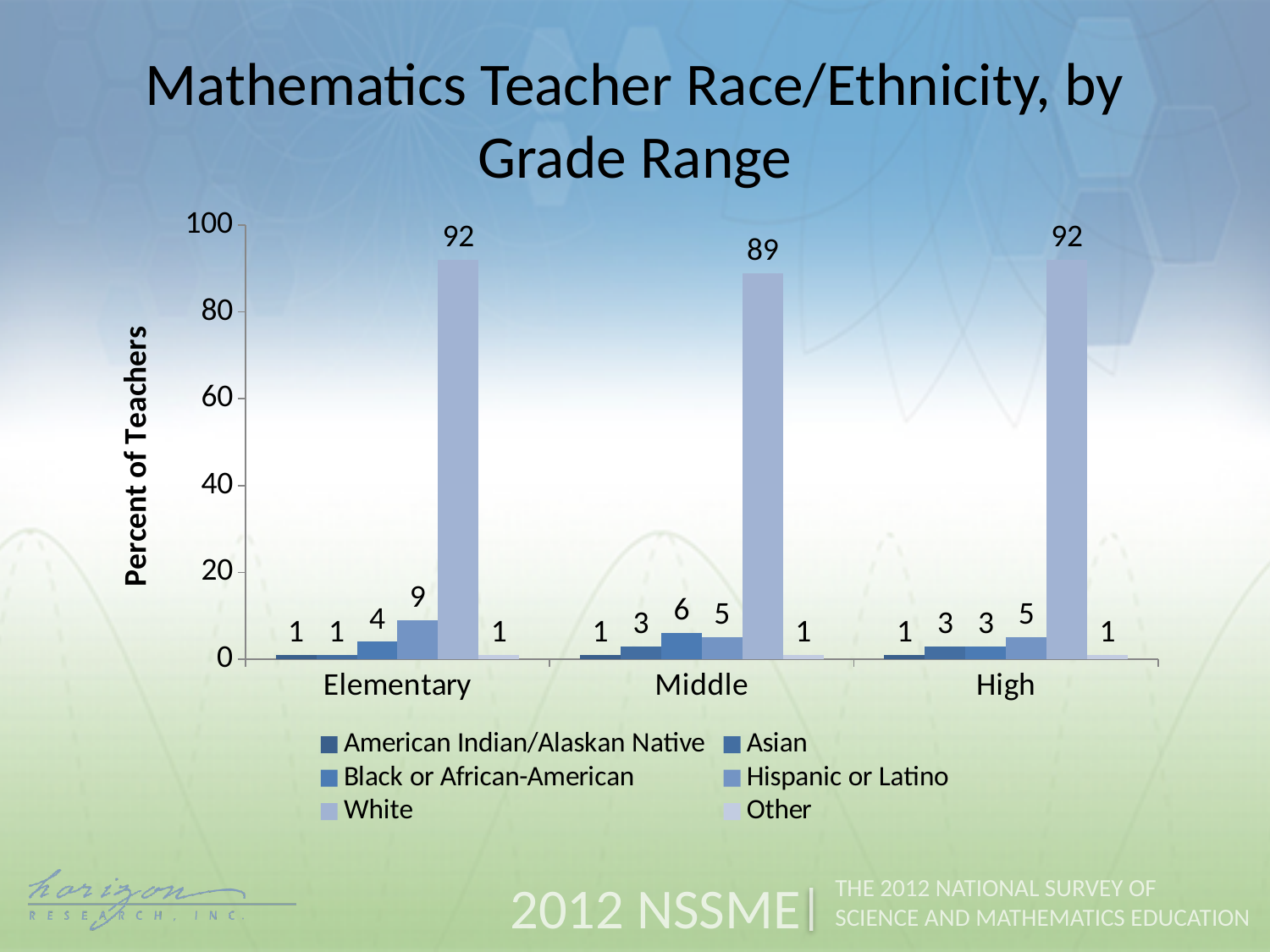
Which is larger: the percentage of Hispanic or Latino teachers at the elementary level or at the high school level? Elementary What is the label of the y axis? Percent of Teachers What percent of middle school mathematics teachers are Black or African-American? 6 What percent of middle school mathematics teachers are White? 89 What percent of high school mathematics teachers are Asian? 3 Is the value for White teachers at the middle level greater or less than 80? greater How many grade ranges are shown on the x axis? 3 What is the difference between the percentage of White teachers at the elementary level and at the middle level? 3 What percent of elementary mathematics teachers are Hispanic or Latino? 9 How many race/ethnicity series does the legend list? 6 Which grade range has the lowest percentage of White mathematics teachers? Middle What kind of chart is shown on the slide? Bar chart